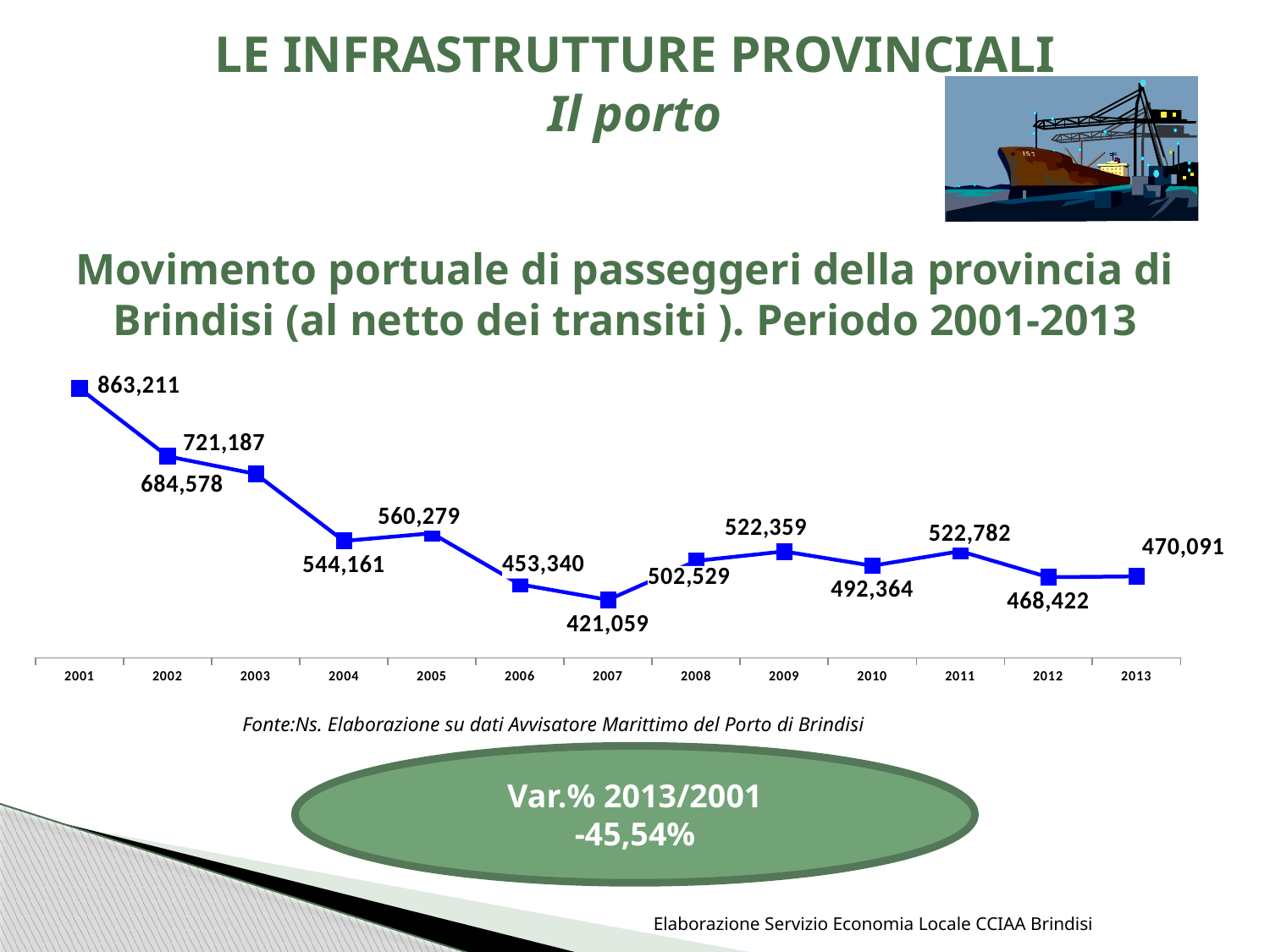
What is the difference between the 2011 value and the 2009 value? 423 What value is shown for 2007? 421,059 Which year has the highest value? 2001 What was the passenger movement value for 2001? 863,211 What is the difference between the 2001 value and the 2013 value? 393,120 How many years are plotted on the chart? 13 Which year has the larger value, 2004 or 2005? 2005 Do the values generally rise or fall from 2001 to 2013? Fall What value is shown for 2013? 470,091 What kind of chart is shown? Line chart What value is shown for 2005? 560,279 Which year has the lowest value? 2007